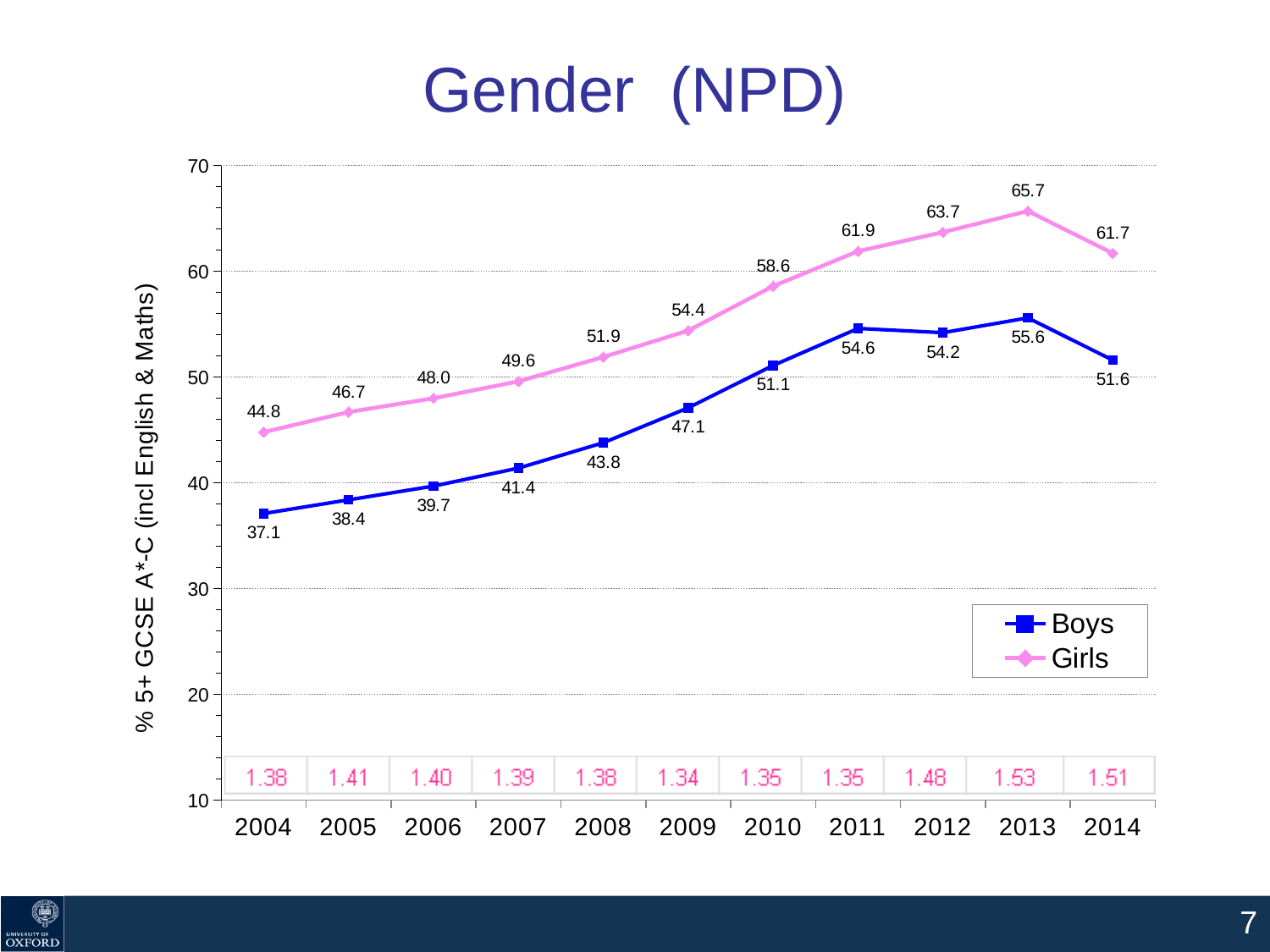
What is the title of the slide? Gender (NPD) Is the value for Boys in 2011 greater or less than 50? greater What is the value for Boys in 2004? 37.1 What is the value for Girls in 2013? 65.7 In which year is the Girls series highest? 2013 How many years are shown on the x axis? 11 What kind of chart is shown on the slide? line chart What is the value for Boys in 2014? 51.6 Which is larger in 2010, the Boys value or the Girls value? Girls How many series does the legend list? 2 What is the difference between the Girls and Boys values in 2014? 10.1 In which year is the Boys series lowest? 2004